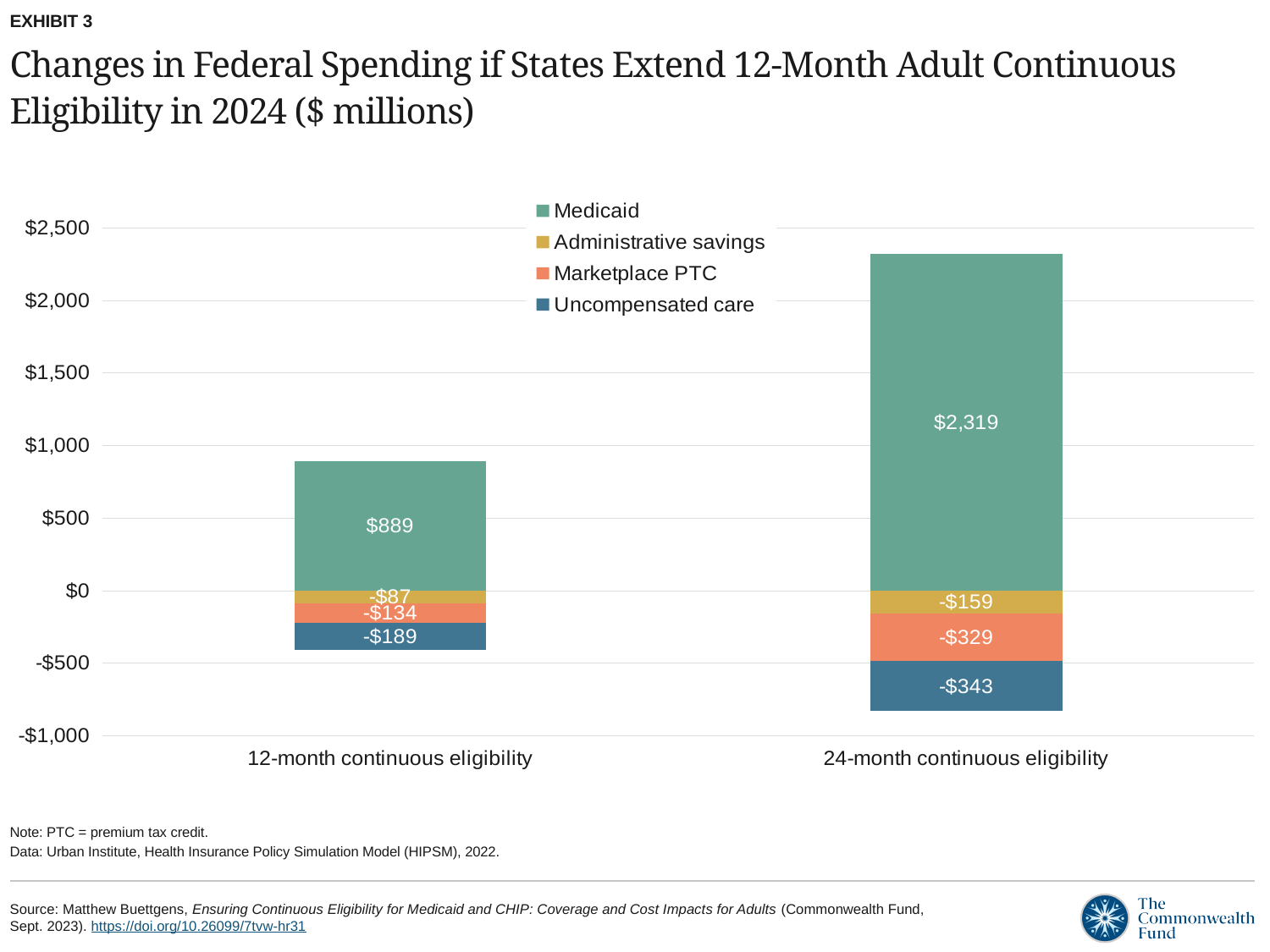
How many series does the legend list? 4 What is the Medicaid value for 24-month continuous eligibility? $2,319 What kind of chart is shown on the slide? Stacked bar chart Which category has the larger Medicaid value, 12-month or 24-month continuous eligibility? 24-month continuous eligibility What is the Administrative savings value for 24-month continuous eligibility? -$159 Is the Medicaid value for 24-month continuous eligibility greater or less than $2,000? greater How many categories are shown on the x axis? 2 How much larger is the Medicaid value for 24-month continuous eligibility than for 12-month continuous eligibility? $1,430 What is the Uncompensated care value for 24-month continuous eligibility? -$343 What is the Marketplace PTC value for 12-month continuous eligibility? -$134 What is the Medicaid value for 12-month continuous eligibility? $889 Is the Medicaid value for 12-month continuous eligibility greater or less than $1,000? less